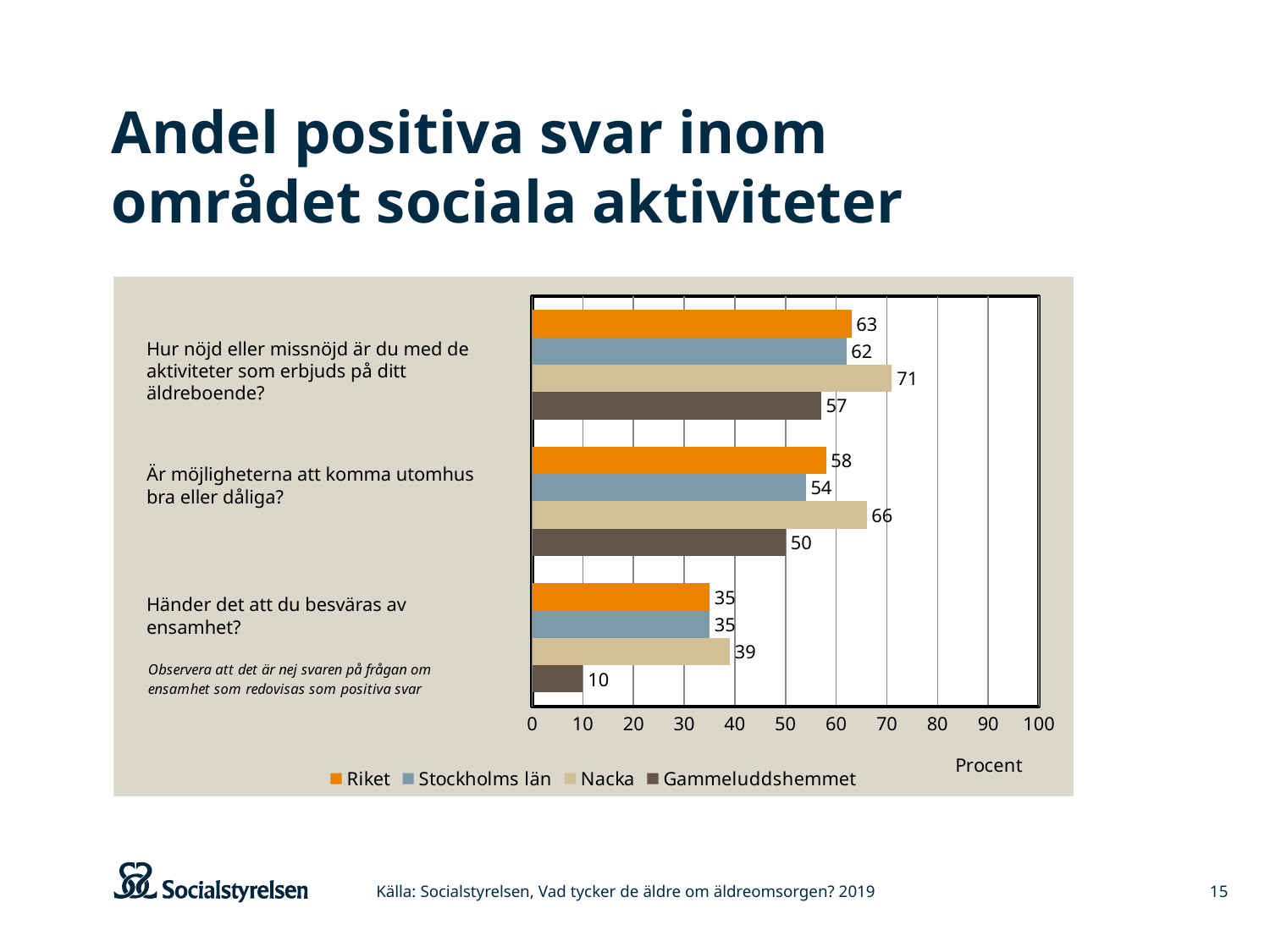
What is the value for Stockholms län on the question "Är möjligheterna att komma utomhus bra eller dåliga?"? 54 What is the value for Gammeluddshemmet on the question "Händer det att du besväras av ensamhet?"? 10 How many questions (categories) are shown in the chart? 3 What kind of chart is shown on the slide? Bar chart What is the difference between the Nacka and Gammeluddshemmet values on the question "Hur nöjd eller missnöjd är du med de aktiviteter som erbjuds på ditt äldreboende?"? 14 What unit is shown on the horizontal axis of the chart? Procent Is the value for Nacka on the question "Händer det att du besväras av ensamhet?" greater or less than 50? less What is the value for Nacka on the question "Hur nöjd eller missnöjd är du med de aktiviteter som erbjuds på ditt äldreboende?"? 71 Which is larger on the question "Är möjligheterna att komma utomhus bra eller dåliga?": Riket or Gammeluddshemmet? Riket Which series has the lowest value on the question "Händer det att du besväras av ensamhet?"? Gammeluddshemmet How many series does the legend list? 4 Which series has the highest value on the question "Är möjligheterna att komma utomhus bra eller dåliga?"? Nacka